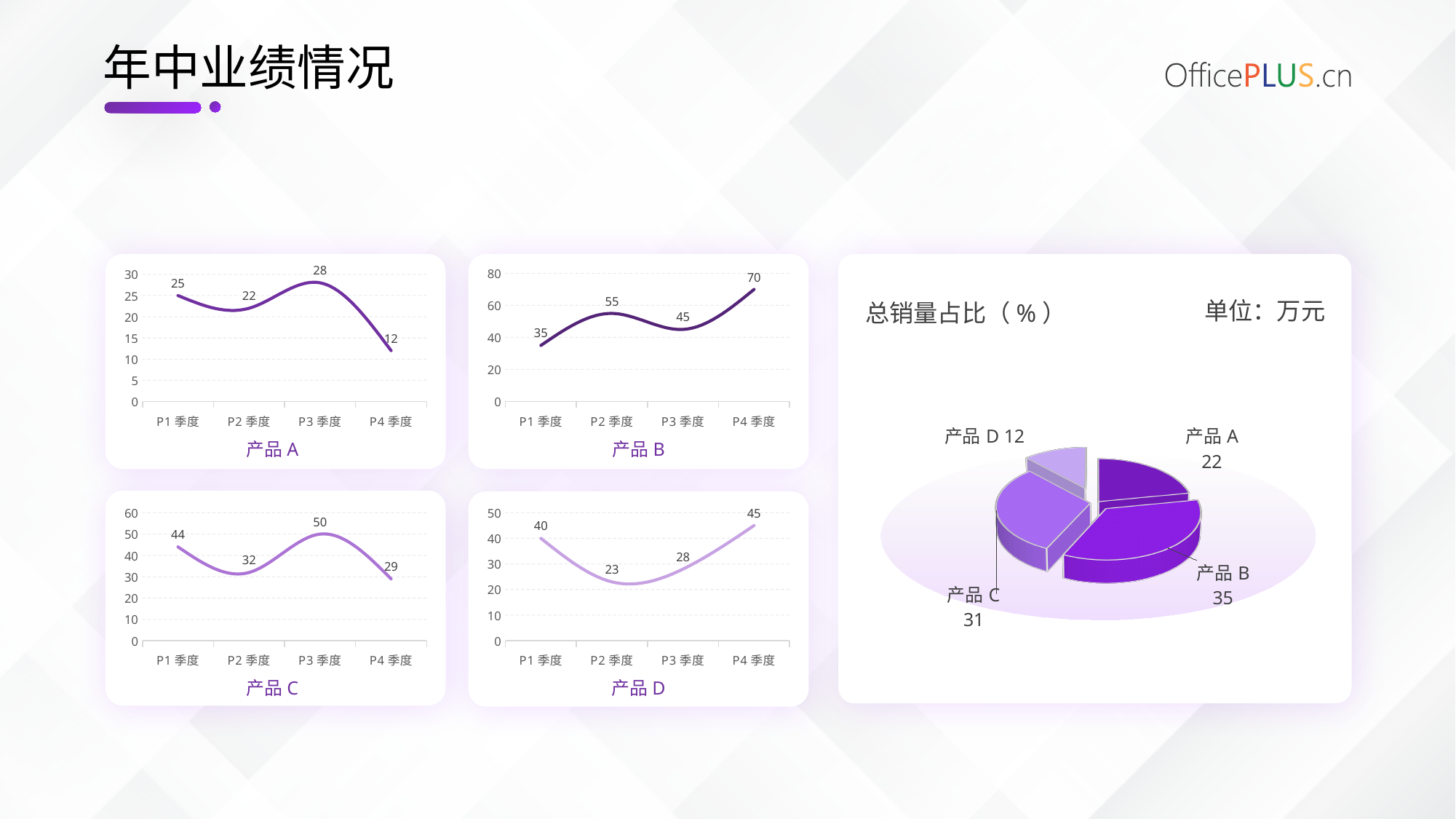
In the 产品 B chart, what is the value for P4 季度? 70 In the 总销量占比 (%) chart, what is the value for 产品 B? 35 In the 产品 B chart, which is larger, the value for P2 季度 or the value for P3 季度? P2 季度 In the 总销量占比 (%) chart, what is the difference between the values for 产品 C and 产品 A? 9 In the 产品 A chart, what is the value for P3 季度? 28 In the 产品 D chart, which quarter has the lowest value? P2 季度 In the 产品 C chart, how many quarters are plotted? 4 In the 产品 A chart, what is the difference between the P1 季度 value and the P4 季度 value? 13 What kind of chart is the 总销量占比 (%) chart? pie chart In the 总销量占比 (%) chart, which product has the smallest slice? 产品 D In the 产品 C chart, which quarter has the highest value? P3 季度 What kind of chart is the 产品 D chart? line chart